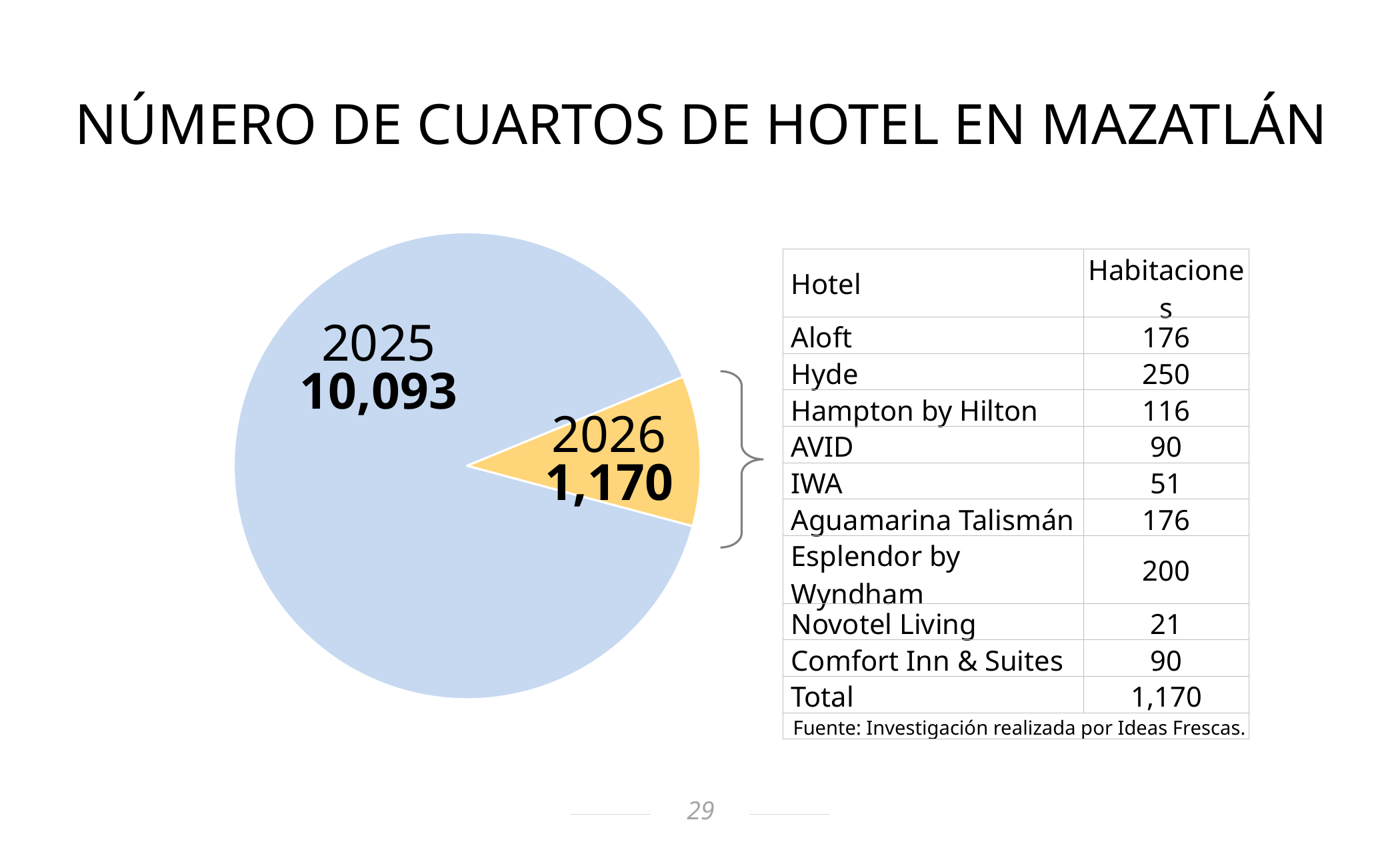
Which is larger in the pie chart, the value for 2025 or the value for 2026? 2025 What kind of chart is shown on the slide? Pie chart What is the total of the two slices in the pie chart? 11,263 What is the value shown for the 2025 slice of the pie chart? 10,093 What is the difference between the 2025 value and the 2026 value in the pie chart? 8,923 Which slice of the pie chart is the smallest? 2026 According to the table next to the pie chart, how many habitaciones does Hyde have? 250 What is the value shown for the 2026 slice of the pie chart? 1,170 What colour is the 2026 slice of the pie chart? Yellow/orange What is the title of the slide containing the pie chart? NÚMERO DE CUARTOS DE HOTEL EN MAZATLÁN How many slices does the pie chart have? 2 Which slice of the pie chart is the largest? 2025